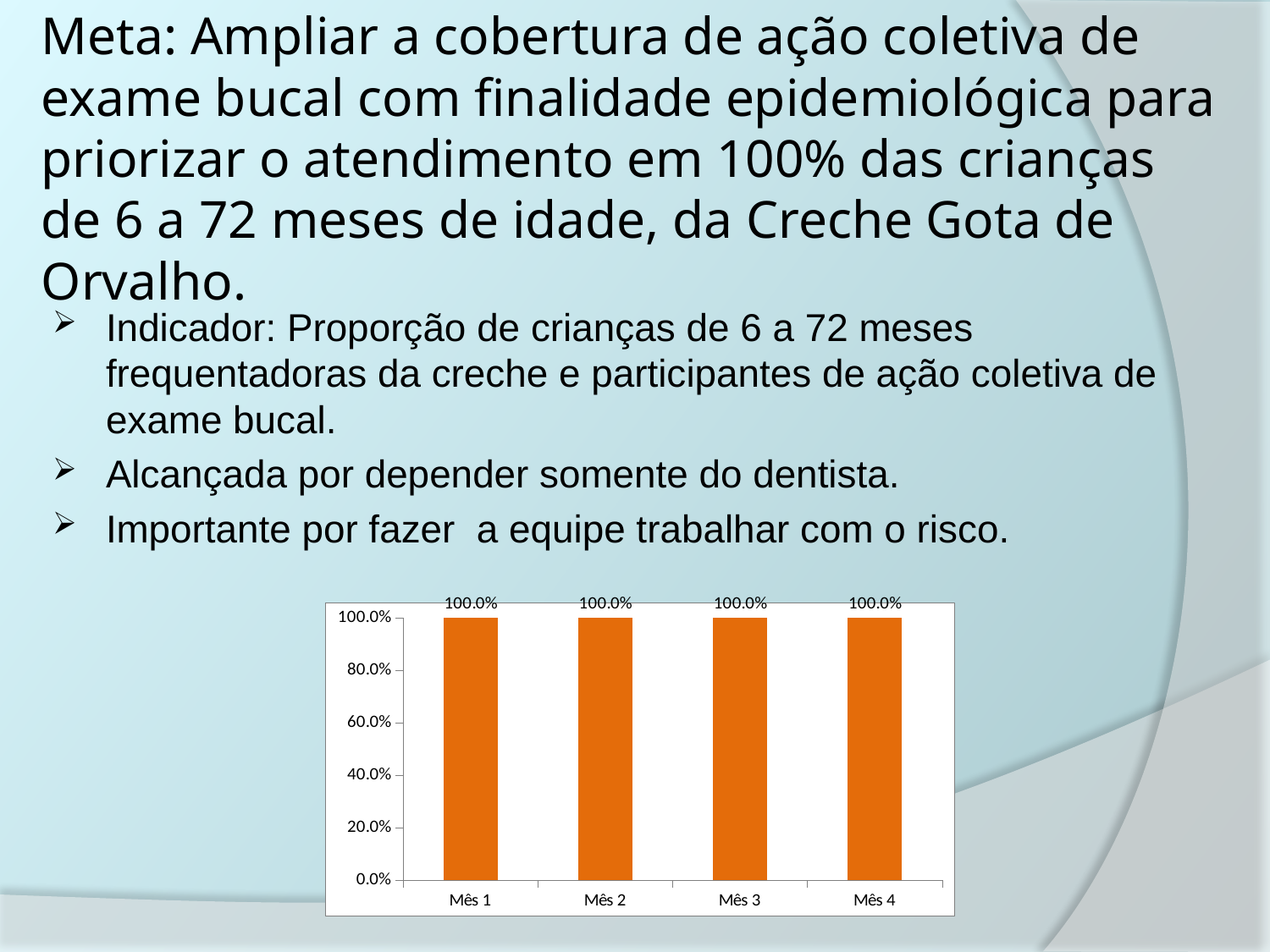
What kind of chart is shown on the slide? Bar chart What colour are the bars in the chart? Orange What is the value for Mês 4 in the bar chart? 100.0% What is the value for Mês 3 in the bar chart? 100.0% Is the value for Mês 2 larger than, smaller than, or equal to the value for Mês 3? Equal Do the values rise, fall or stay the same from Mês 1 to Mês 4? Stay the same Is the value for Mês 3 greater or less than 80.0%? greater What is the value for Mês 1 in the bar chart? 100.0% What is the difference between the values for Mês 1 and Mês 4? 0.0% What is the value for Mês 2 in the bar chart? 100.0% How many categories are shown on the x axis of the chart? 4 What is the highest value shown on the y axis of the chart? 100.0%